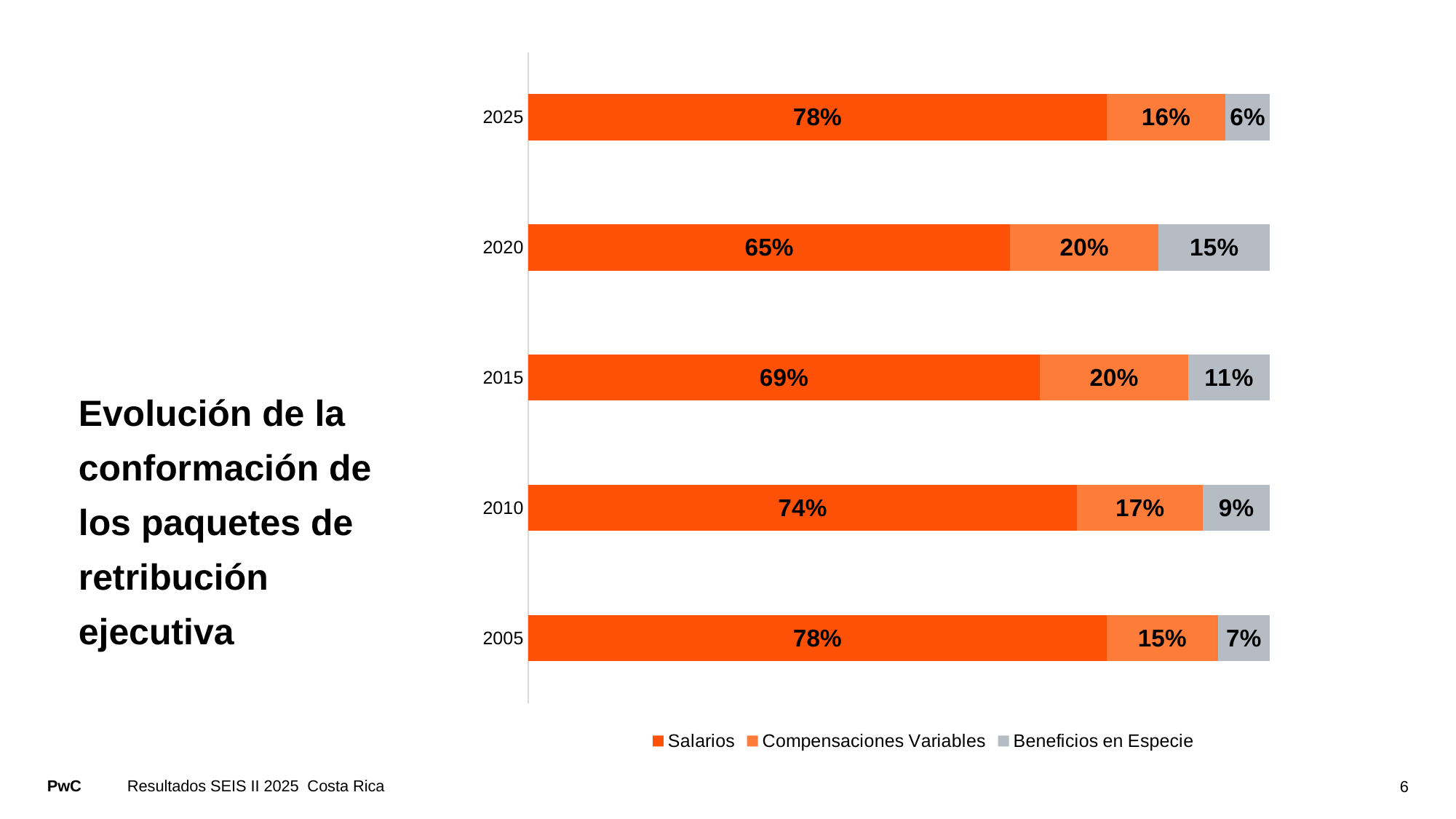
How many years are shown on the chart? 5 What kind of chart is shown on the slide? Stacked bar chart Which series is shown in grey in the legend? Beneficios en Especie What is the Compensaciones Variables value for 2010? 17% What is the total of the stacked bar for 2010? 100% What is the Beneficios en Especie value for 2015? 11% What is the Salarios value for 2020? 65% What is the difference between the Salarios values for 2025 and 2020? 13% How many series does the legend list? 3 Which is larger, the Compensaciones Variables value for 2015 or for 2005? 2015 Which year has the lowest Salarios value? 2020 Which year has the highest Beneficios en Especie value? 2020